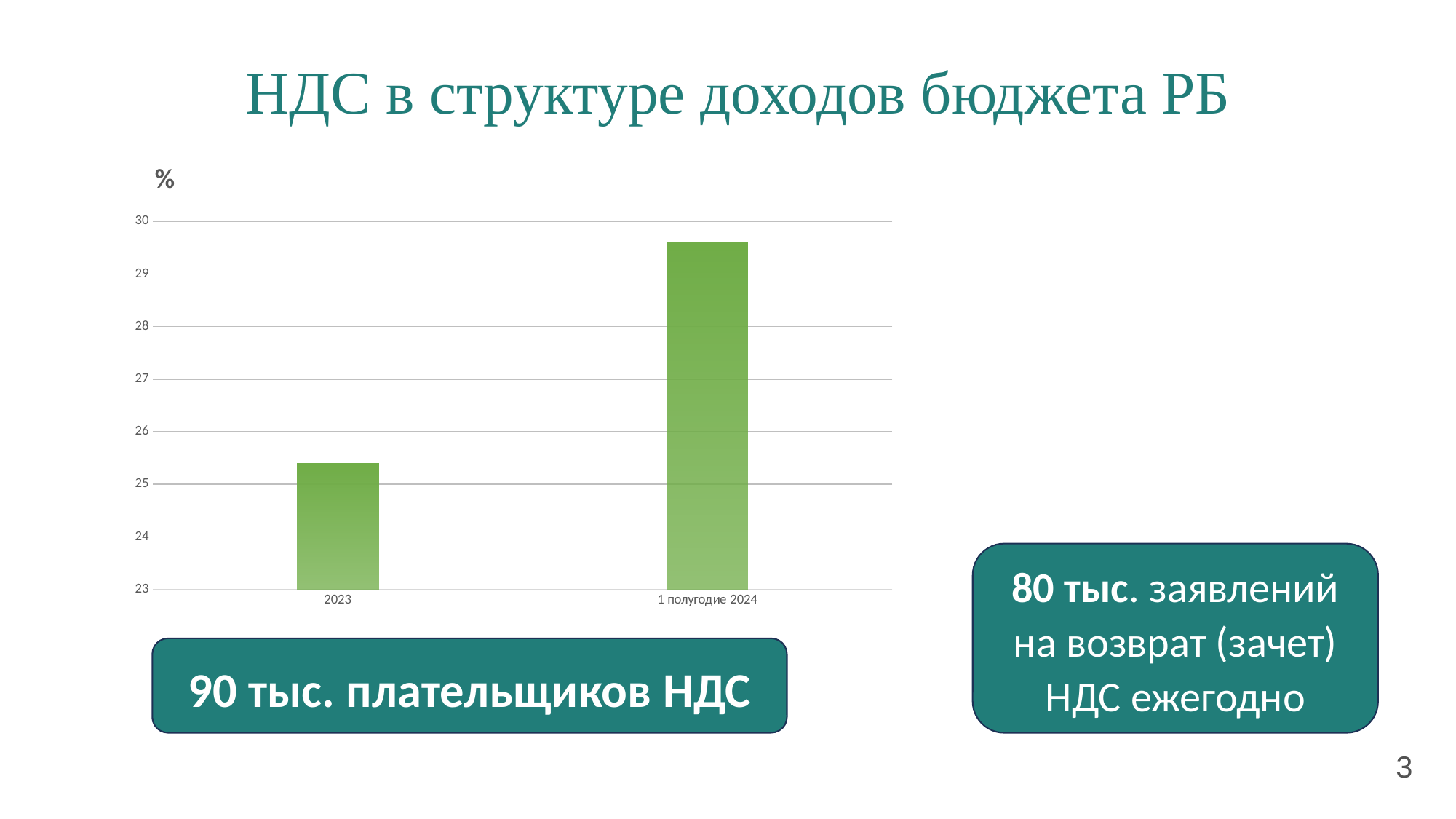
How many bars (categories) does the chart show? 2 Which is larger: the value for 2023 or the value for 1 полугодие 2024? 1 полугодие 2024 What kind of chart is shown on the slide? bar chart Is the value for 1 полугодие 2024 greater or less than 29? greater Is the value for 1 полугодие 2024 greater or less than 30? less Is the value for 2023 greater or less than 25? greater Which category has the highest value in the chart? 1 полугодие 2024 Do the values rise or fall from 2023 to 1 полугодие 2024? rise Which category has the lowest value in the chart? 2023 What is the title of the slide containing the chart? НДС в структуре доходов бюджета РБ What unit is shown on the vertical axis of the chart? %